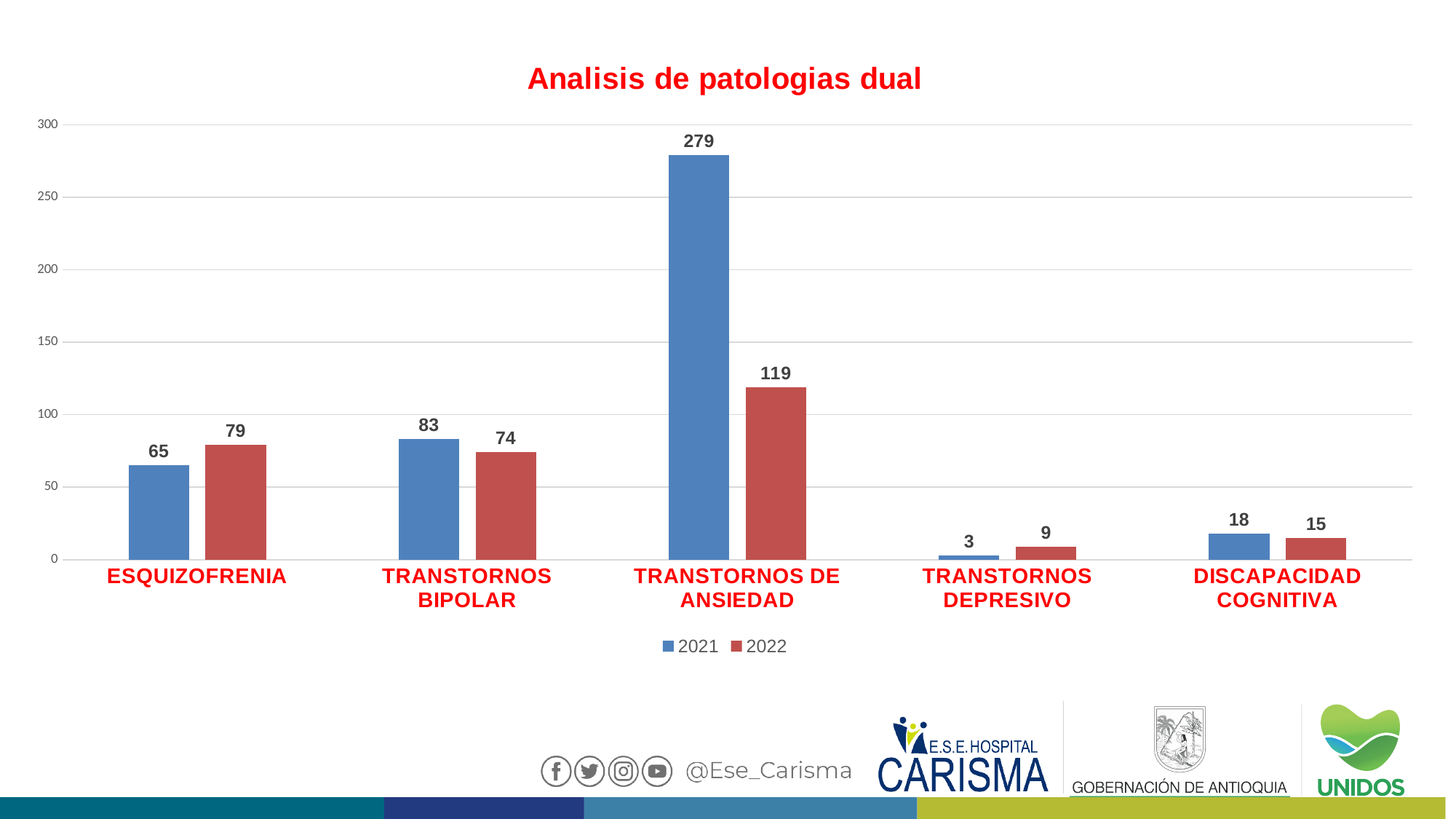
Is the 2022 value for TRANSTORNOS DE ANSIEDAD greater or less than 100? greater What is the difference between the 2021 and 2022 values for TRANSTORNOS DE ANSIEDAD? 160 What is the 2022 value for TRANSTORNOS DEPRESIVO? 9 How many categories are shown on the x axis? 5 What kind of chart is shown on the slide? Bar chart Which category has the lowest 2022 value? TRANSTORNOS DEPRESIVO What is the 2022 value for ESQUIZOFRENIA? 79 What is the 2021 value for TRANSTORNOS DE ANSIEDAD? 279 Which category has the highest 2021 value? TRANSTORNOS DE ANSIEDAD Which is larger for TRANSTORNOS BIPOLAR, the 2021 value or the 2022 value? 2021 What is the title of the chart? Analisis de patologias dual How many series does the legend list? 2